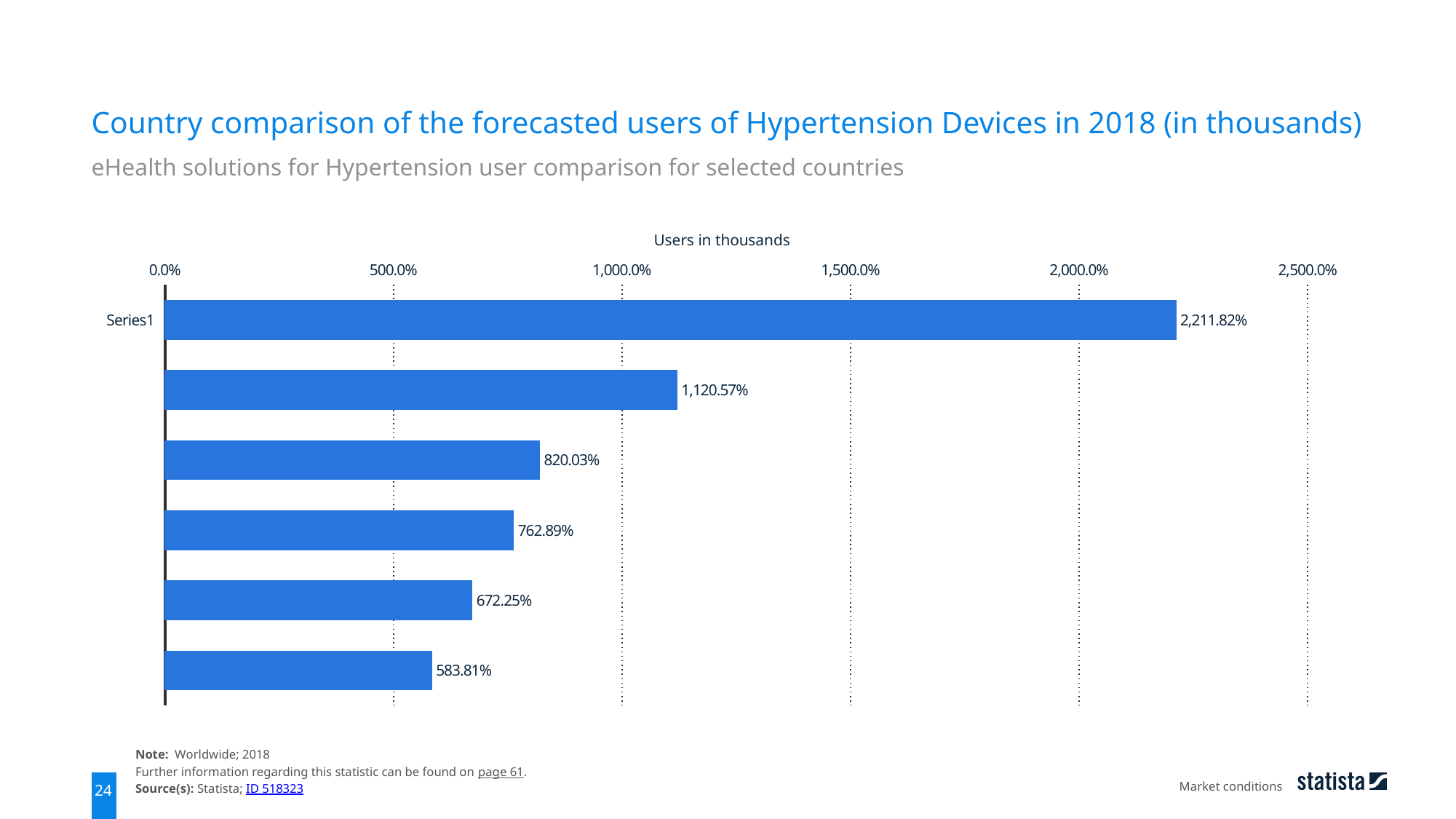
Which bar has the lowest value? the bottom bar What is the value shown on the second bar from the top? 1,120.57% Which bar has the highest value? the top bar (Series1) What kind of chart is shown on the slide? bar chart Which is larger, the third bar from the top or the fourth bar from the top? the third bar from the top Do the bar values rise or fall going from the top bar to the bottom bar? fall What is the value shown on the bottom bar? 583.81% What is the axis title shown above the chart? Users in thousands What is the value shown on the fourth bar from the top? 762.89% How many bars are plotted in the chart? 6 What is the difference between the top bar's value and the second bar's value? 1,091.25% What is the value shown on the top bar, labelled Series1? 2,211.82%